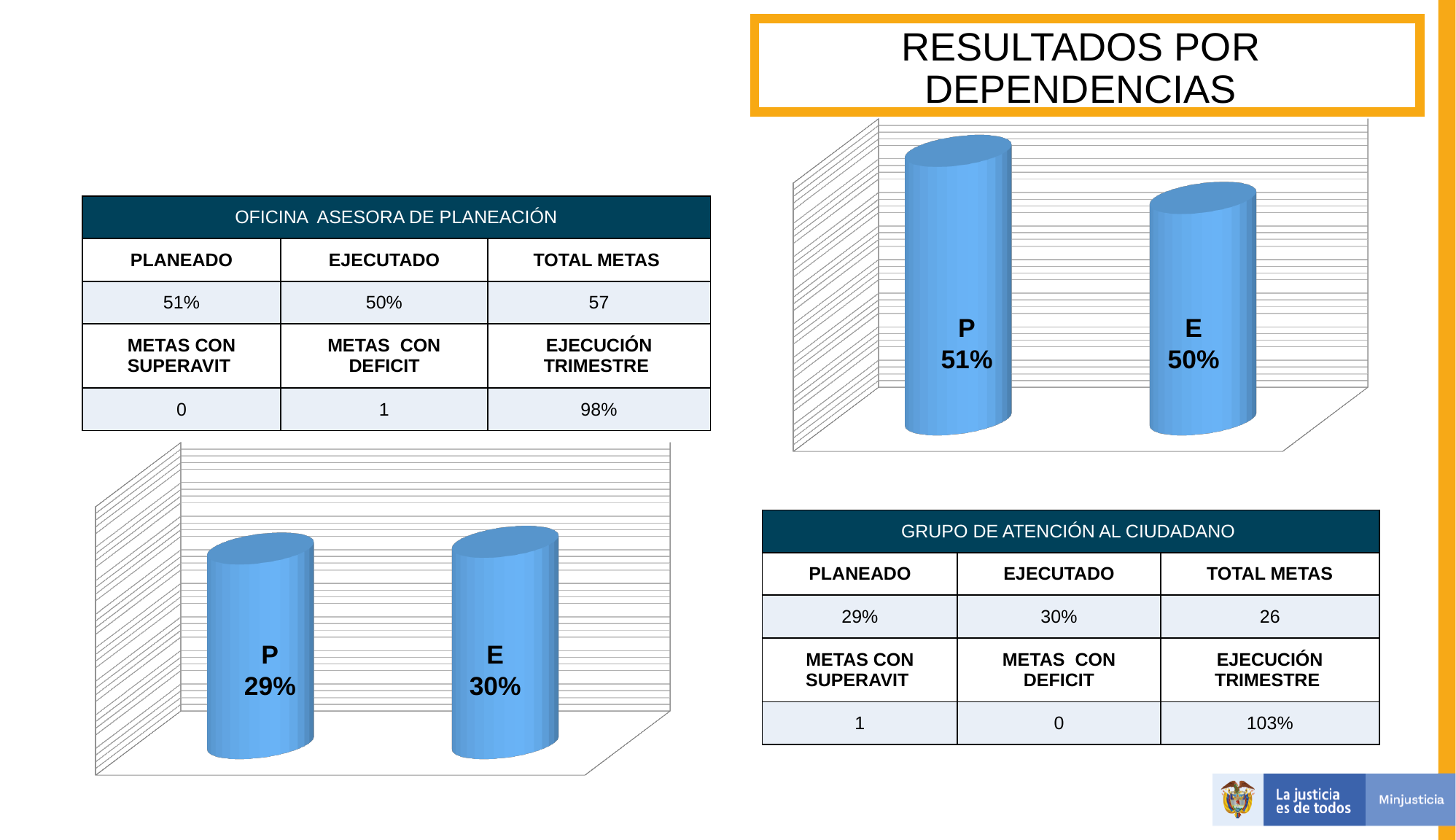
On the chart at the bottom left of the slide, what is the difference between the E value and the P value? 1% On the chart at the top right of the slide, what is the value labelled for E? 50% What kind of chart is shown at the top right of the slide? Bar chart On the chart at the bottom left of the slide, what is the value labelled for P? 29% On the chart at the top right of the slide, which bar is higher, P or E? P On the chart at the bottom left of the slide, which bar is higher, P or E? E What colour are the bars on the chart at the bottom left of the slide? Blue How many bars are shown on the chart at the top right of the slide? 2 On the chart at the top right of the slide, what is the difference between the P value and the E value? 1% On the chart at the bottom left of the slide, what is the value labelled for E? 30% On the chart at the top right of the slide, what is the value labelled for P? 51% How many bars are shown on the chart at the bottom left of the slide? 2